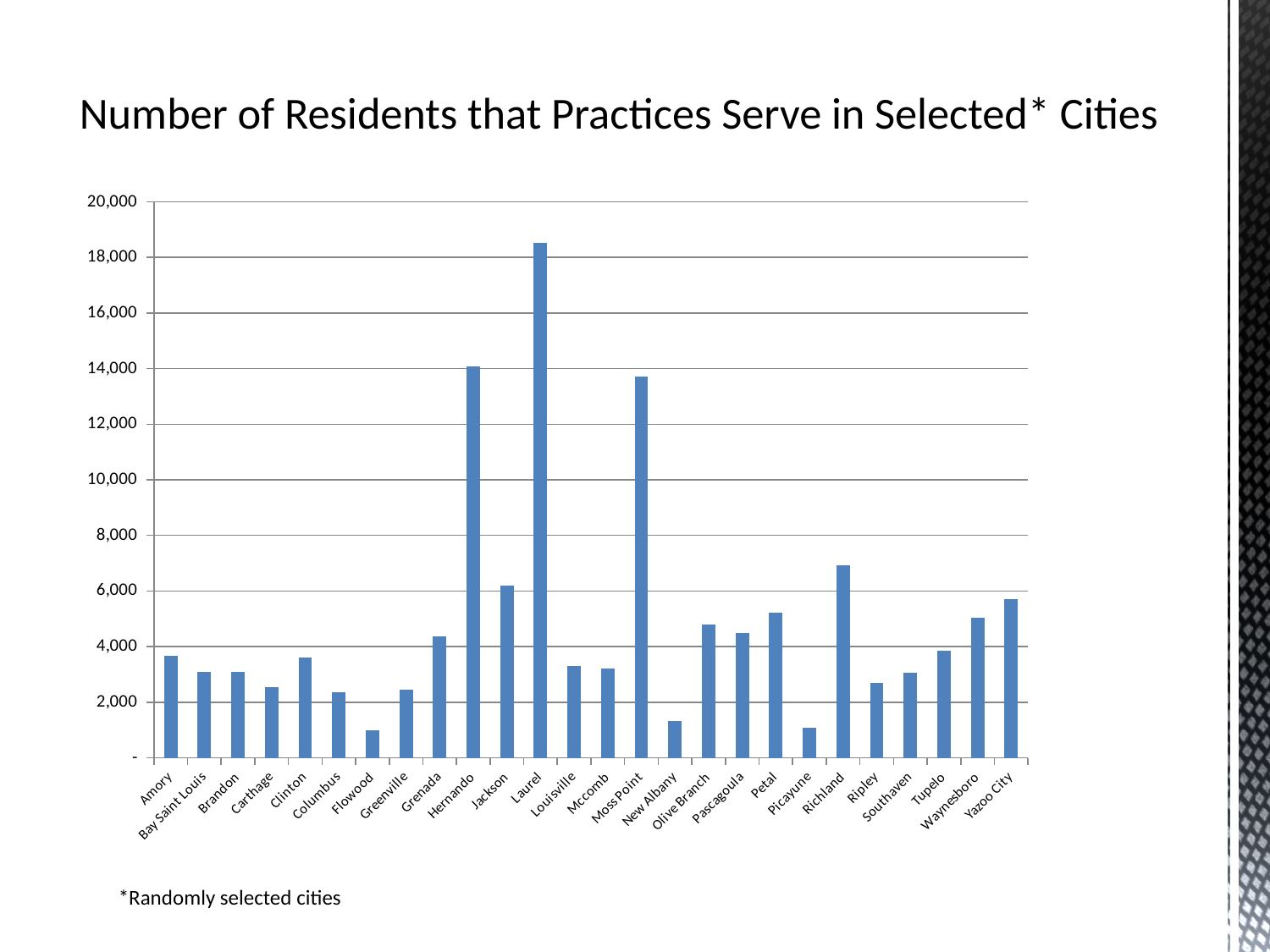
Is the value for Yazoo City greater or less than 6,000? less Which is larger, the value for Laurel or the value for Hernando? Laurel Is the value for New Albany greater or less than 2,000? less Is the value for Moss Point greater or less than 14,000? less Which is larger, the value for Richland or the value for Yazoo City? Richland What is the title of the chart? Number of Residents that Practices Serve in Selected* Cities How many cities are shown on the x axis? 26 What kind of chart is shown on the slide? bar chart Which city has the highest number of residents served? Laurel